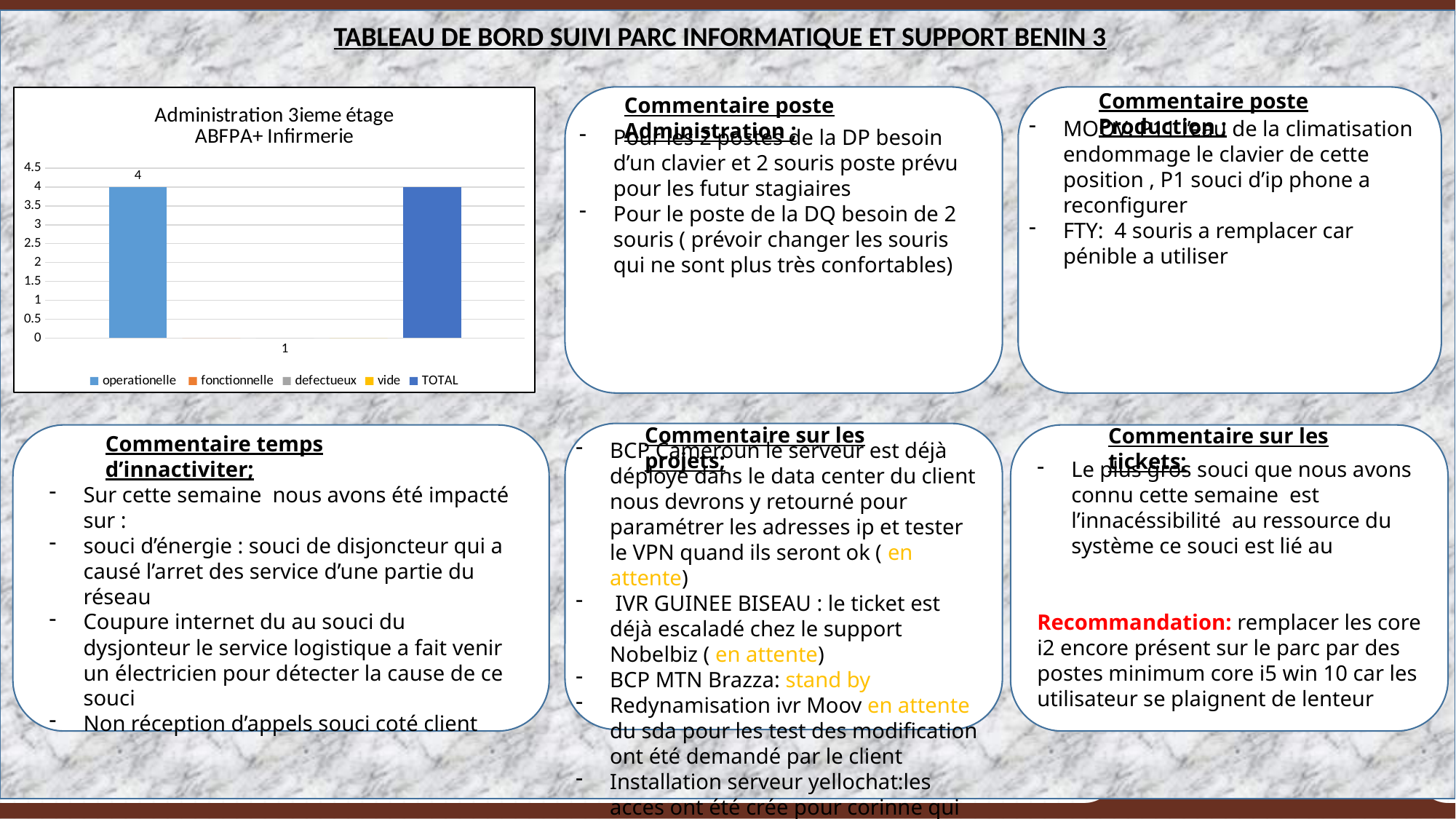
What is the title of the chart? Administration 3ieme étage ABFPA+ Infirmerie How many series does the chart legend list? 5 Is the value for fonctionnelle greater or less than 1? less Is the value for operationelle greater or less than 3? greater What is the value of the operationelle series in the chart? 4 What is the value of the TOTAL series in the chart? 4 Which is larger, the value for TOTAL or the value for defectueux? TOTAL How many categories are shown on the x axis of the chart? 1 What is the highest value shown on the chart's y axis? 4.5 What kind of chart is shown on the slide? bar chart Which is larger, the value for operationelle or the value for fonctionnelle? operationelle